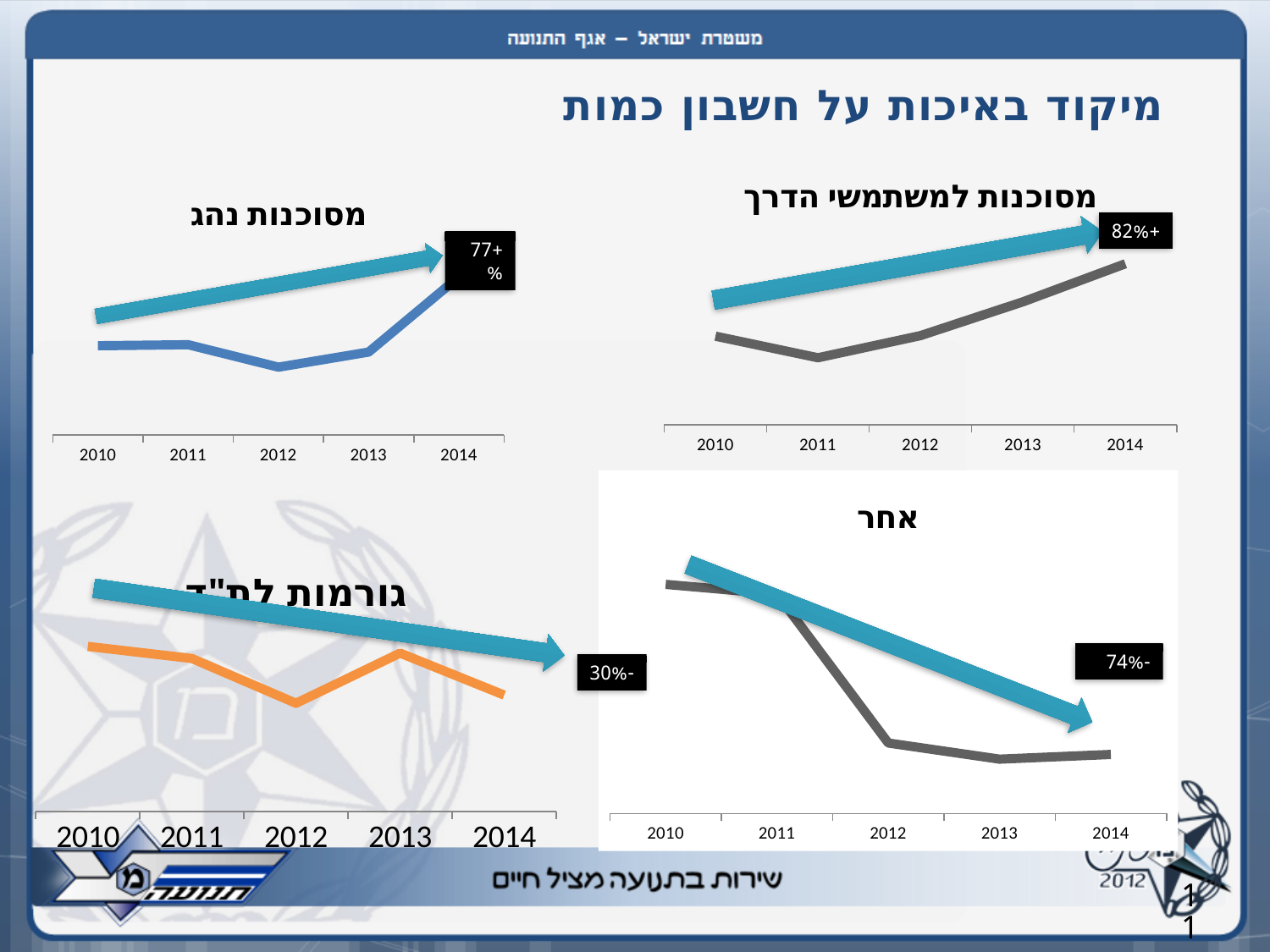
How many years are shown on the x axis of the chart titled "מסוכנות למשתמשי הדרך"? 5 In the chart titled "אחר", which year has the higher value, 2010 or 2013? 2010 What percentage change is labelled on the chart titled "מסוכנות נהג"? +77% What percentage change is labelled on the chart titled "מסוכנות למשתמשי הדרך"? +82% In the chart titled "מסוכנות למשתמשי הדרך", do the values rise or fall from 2011 to 2014? rise In the chart titled "מסוכנות נהג", which year has the highest value? 2014 What kind of chart is the chart titled "מסוכנות נהג"? line chart In the chart titled "אחר", do the values rise or fall from 2010 to 2014? fall What percentage change is labelled on the chart titled "אחר"? -74% What percentage change is labelled on the chart titled "גורמות לת"ד"? -30% In the chart titled "מסוכנות למשתמשי הדרך", which year has the lowest value? 2011 What is the first year shown on the x axis of the chart titled "גורמות לת"ד"? 2010